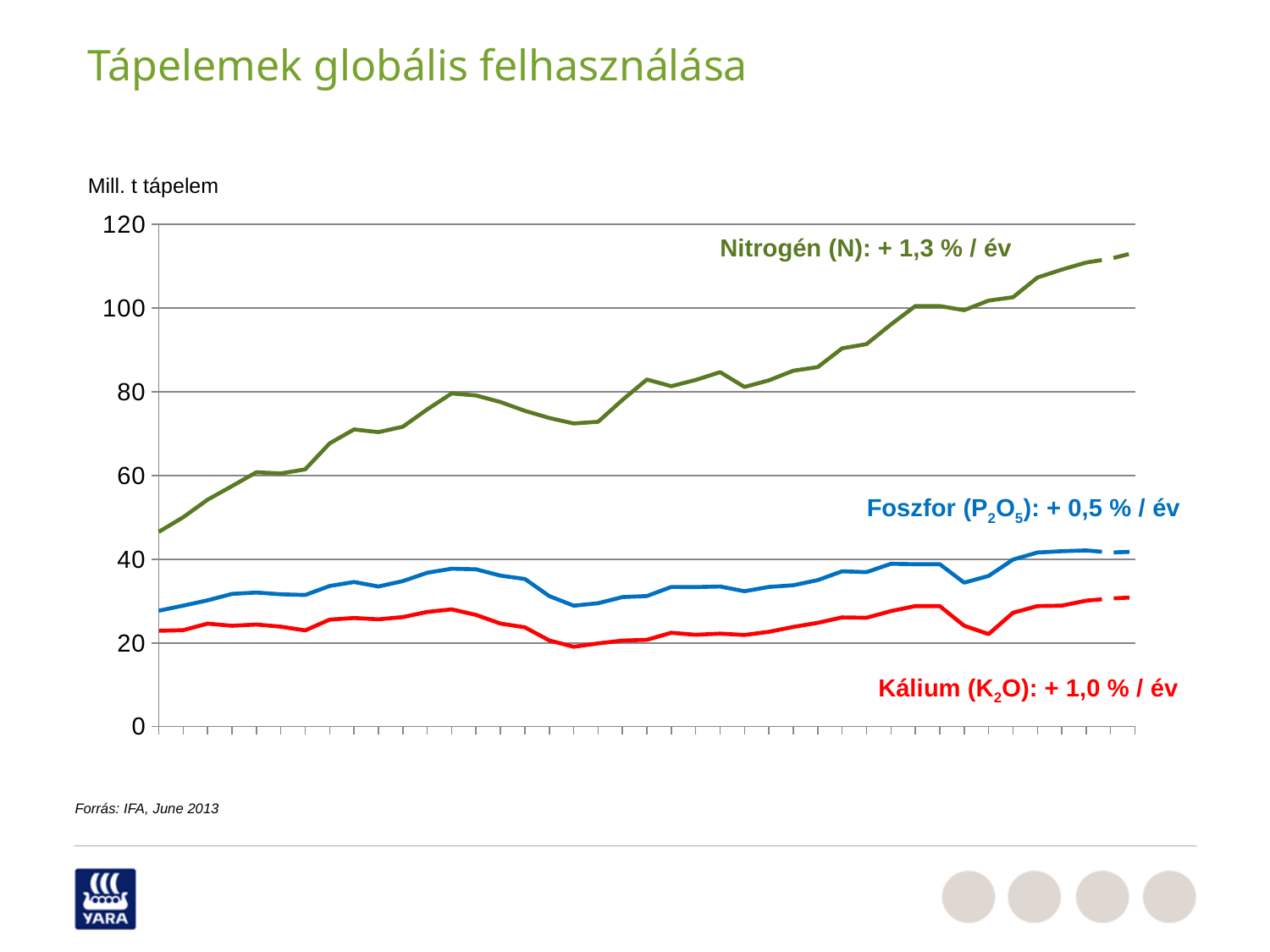
What annual growth rate is printed for Foszfor (P2O5)? + 0,5 % / év Is the final value of the Nitrogén (N) line greater or less than 100? greater Is the highest value reached by the Kálium (K2O) line greater or less than 40? less What annual growth rate is printed for Nitrogén (N)? + 1,3 % / év Does the Nitrogén (N) line generally rise or fall from left to right? rise What unit is shown above the y axis of the chart? Mill. t tápelem How many series are plotted on the chart? 3 What is the title of the chart on the slide? Tápelemek globális felhasználása Which series has the highest values throughout the chart? Nitrogén (N) What annual growth rate is printed for Kálium (K2O)? + 1,0 % / év What kind of chart is shown on the slide? line chart Which series has the lowest values throughout the chart? Kálium (K2O)